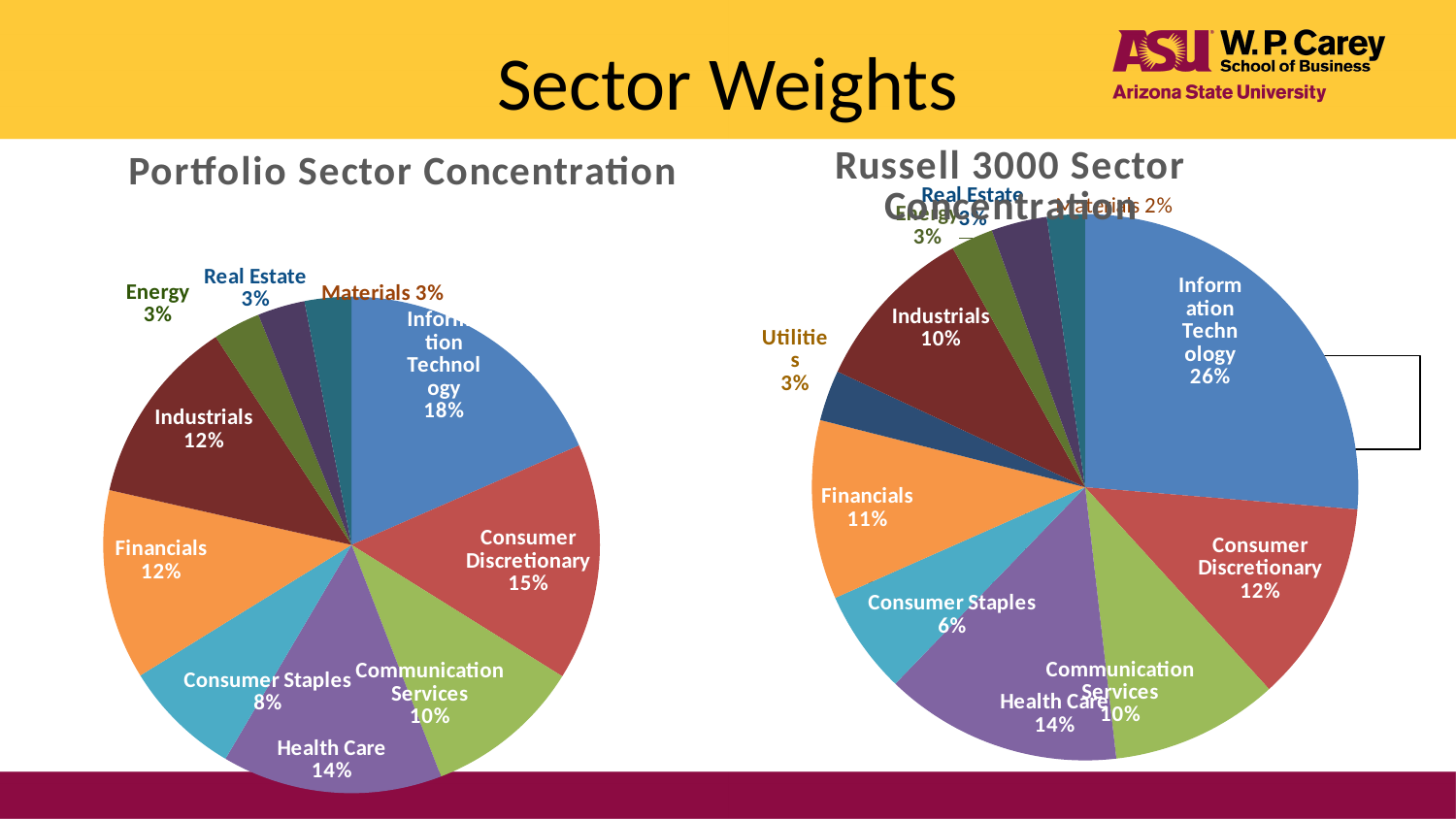
In the Russell 3000 Sector Concentration pie chart, which sector has the largest slice? Information Technology In the Portfolio Sector Concentration pie chart, which sector has the largest slice? Information Technology In the Portfolio Sector Concentration pie chart, what is the share for Information Technology? 18% In the Portfolio Sector Concentration pie chart, what is the share for Health Care? 14% In the Russell 3000 Sector Concentration pie chart, what is the share for Consumer Staples? 6% What type of chart is used for the Portfolio Sector Concentration? Pie chart How many percentage points higher is the Information Technology share in the Russell 3000 Sector Concentration chart than in the Portfolio Sector Concentration chart? 8 percentage points In the Russell 3000 Sector Concentration pie chart, what is the share for Information Technology? 26% What is the difference between the Consumer Discretionary share in the Portfolio Sector Concentration chart and in the Russell 3000 Sector Concentration chart? 3 percentage points Is the Financials share larger in the Portfolio Sector Concentration chart or in the Russell 3000 Sector Concentration chart? Portfolio Sector Concentration In the Russell 3000 Sector Concentration pie chart, what is the share for Utilities? 3% How many sectors are shown in the Portfolio Sector Concentration pie chart? 10